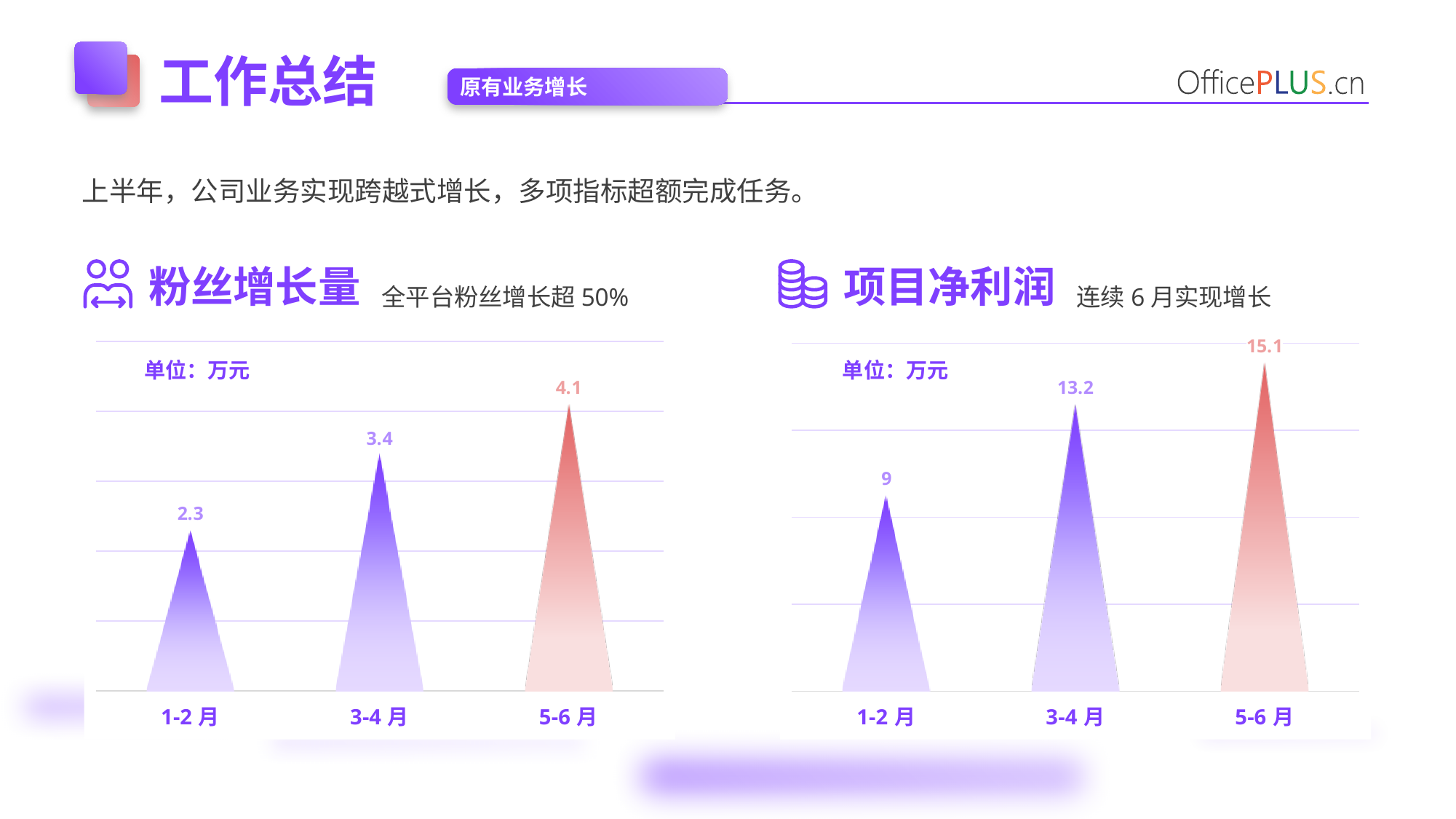
In the 粉丝增长量 chart, what is the value for 3-4 月? 3.4 In the 粉丝增长量 chart, what is the value for 1-2 月? 2.3 In the 粉丝增长量 chart, what is the difference between the values for 5-6 月 and 1-2 月? 1.8 In the 项目净利润 chart, what is the difference between the values for 3-4 月 and 1-2 月? 4.2 In the 项目净利润 chart, what is the value for 1-2 月? 9 What unit is stated on the 粉丝增长量 chart? 万元 Do the values in the 项目净利润 chart rise or fall from 1-2 月 to 5-6 月? rise In the 项目净利润 chart, which is larger, the value for 3-4 月 or 5-6 月? 5-6 月 How many periods are shown on the x axis of the 粉丝增长量 chart? 3 In the 项目净利润 chart, which period has the lowest value? 1-2 月 In the 粉丝增长量 chart, which period has the highest value? 5-6 月 In the 项目净利润 chart, what is the value for 5-6 月? 15.1